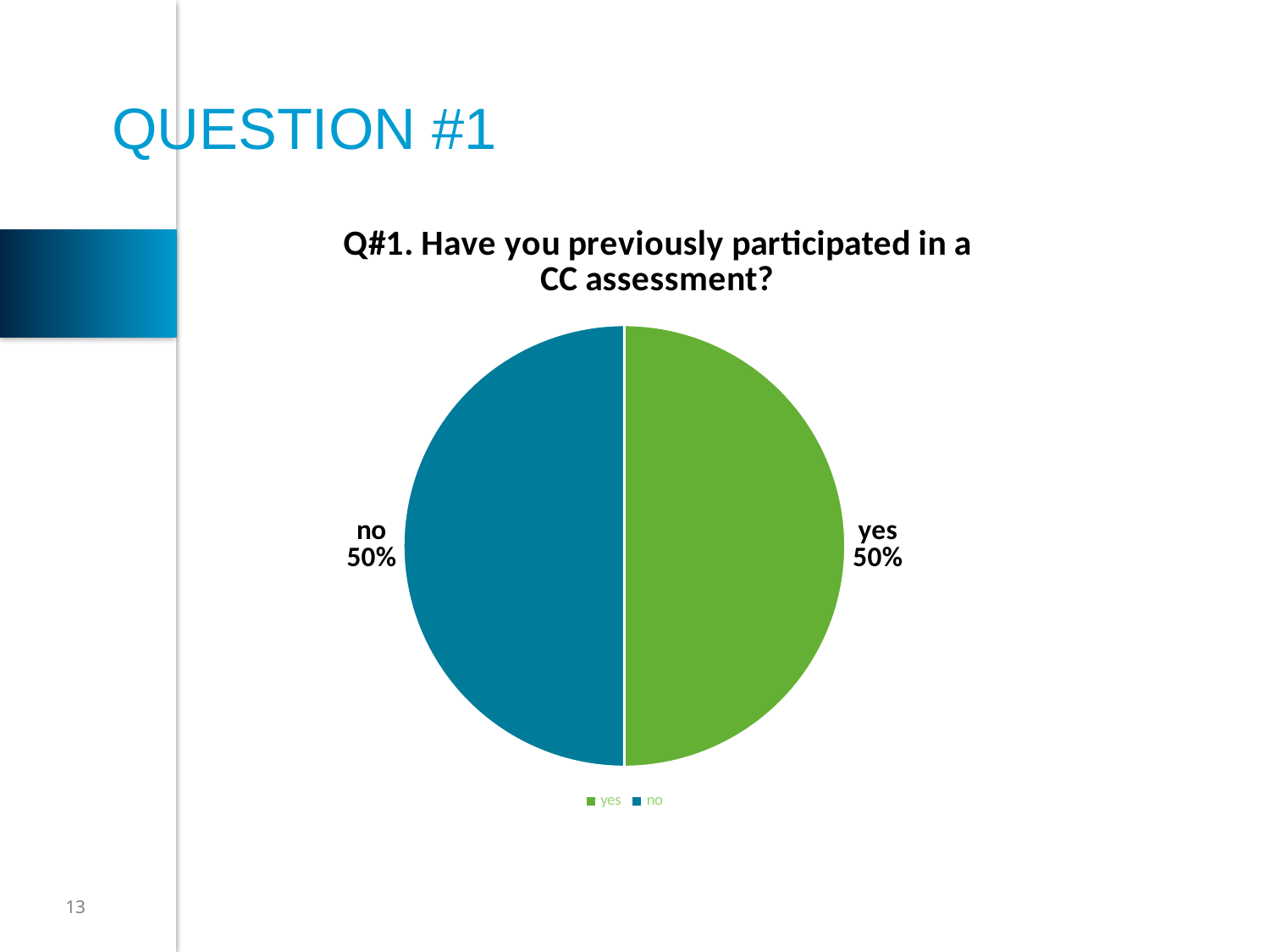
How many slices does the pie chart have? 2 What percentage of respondents answered "no"? 50% What share of the pie does the "no" slice represent? 50% What is the title of the chart? Q#1. Have you previously participated in a CC assessment? Which colour represents the "yes" slice? green What type of chart is shown on the slide? pie chart How many entries does the legend list? 2 What is the difference between the "yes" and "no" shares? 0% Is the share for "no" greater or less than 60%? less What percentage of respondents answered "yes"? 50% Is the share for "yes" greater or less than 40%? greater